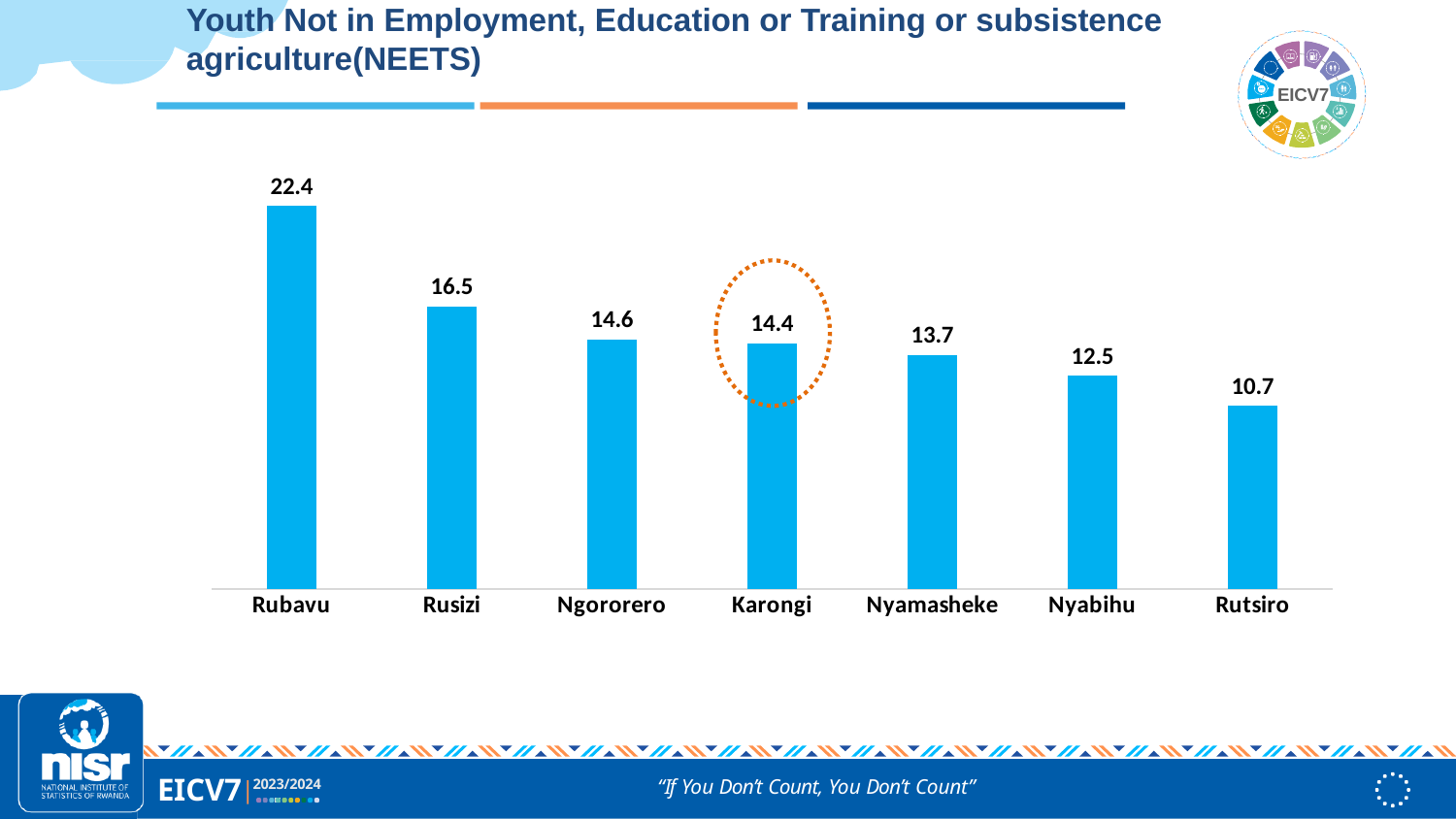
Which is larger, the value for Nyamasheke or the value for Nyabihu? Nyamasheke Which district's bar is highlighted with a dashed orange circle? Karongi Which district has the highest value? Rubavu How many districts are shown in the chart? 7 What kind of chart is shown on the slide? Bar chart What is the difference between the values for Ngororero and Rutsiro? 3.9 What is the difference between the values for Rubavu and Rusizi? 5.9 Do the values rise or fall from left to right across the districts? Fall What is the value for Rubavu? 22.4 What is the value for Karongi? 14.4 Which district has the lowest value? Rutsiro What is the value for Nyabihu? 12.5